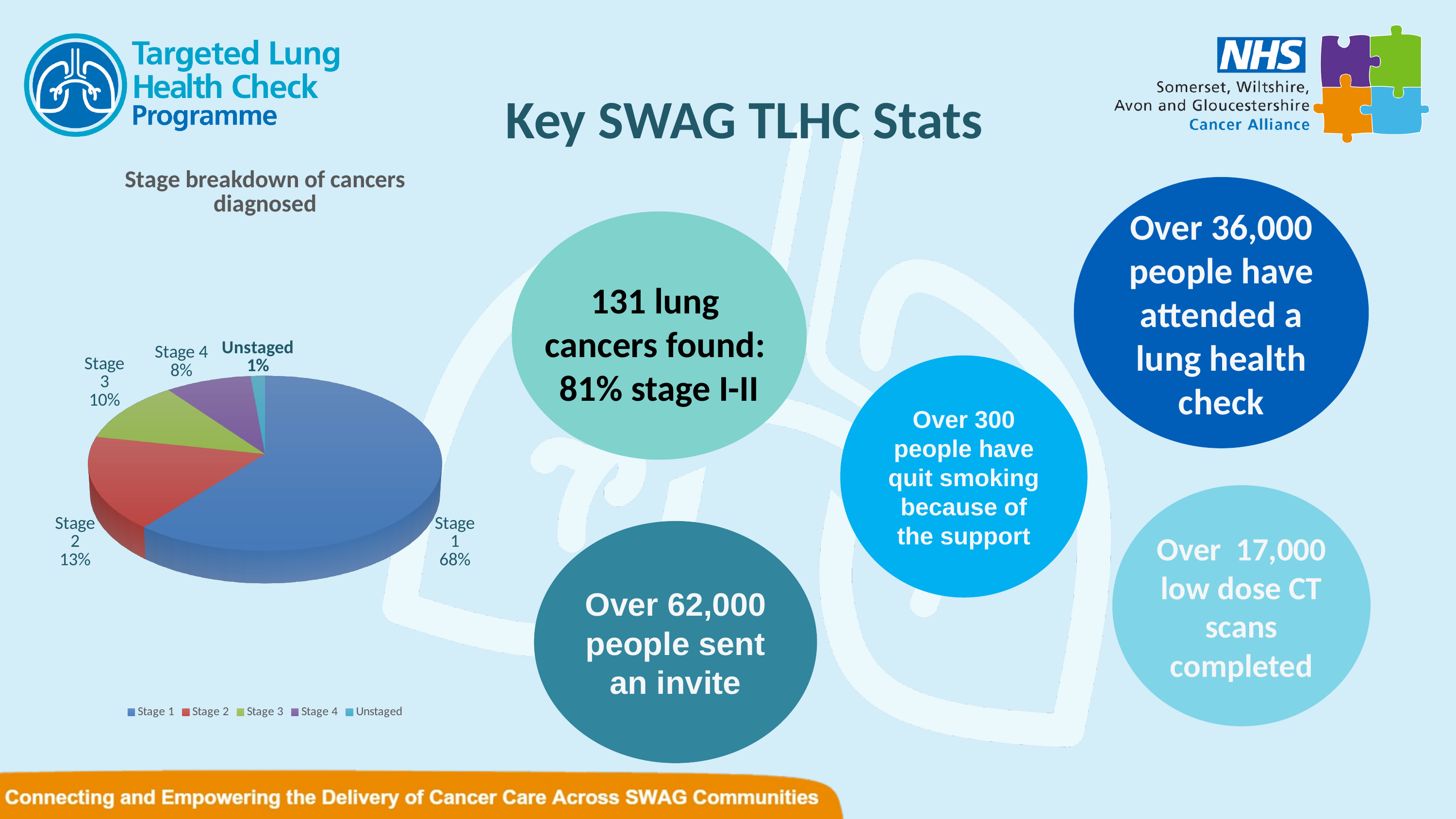
What percentage of cancers diagnosed were Stage 2? 13% Which stage has the largest share of cancers diagnosed? Stage 1 What colour is the Stage 4 slice in the pie chart? purple Which category has the smallest share of cancers diagnosed? Unstaged What is the title of the chart? Stage breakdown of cancers diagnosed What percentage of cancers diagnosed were Stage 1? 68% Which is larger, the share for Stage 3 or the share for Stage 4? Stage 3 What percentage of cancers diagnosed were Stage 3? 10% What percentage of cancers diagnosed were Unstaged? 1% How many categories does the pie chart show? 5 What kind of chart is shown on the slide? pie chart What is the difference in percentage points between Stage 1 and Stage 2? 55